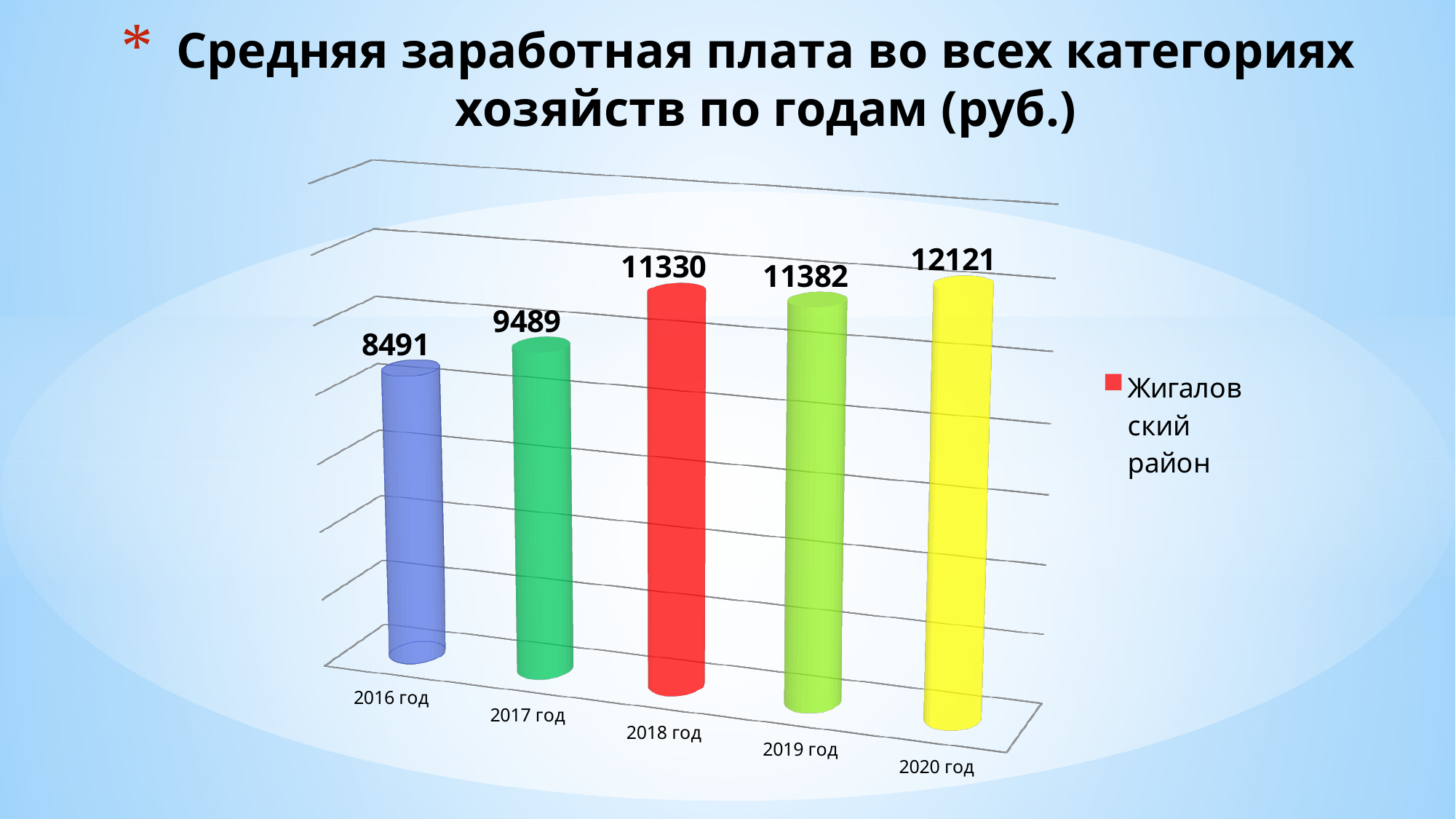
Do the values rise or fall from 2016 год to 2020 год? rise What is the difference between the values for 2017 год and 2016 год? 998 Which year has the lowest value? 2016 год Which is larger, the value for 2017 год or the value for 2019 год? 2019 год How many years are shown on the chart? 5 What is the value for 2018 год? 11330 What is the value for 2016 год? 8491 What is the difference between the values for 2020 год and 2016 год? 3630 What is the value for 2020 год? 12121 Which year has the highest value? 2020 год How many series does the legend list? 1 What kind of chart is shown on the slide? bar chart